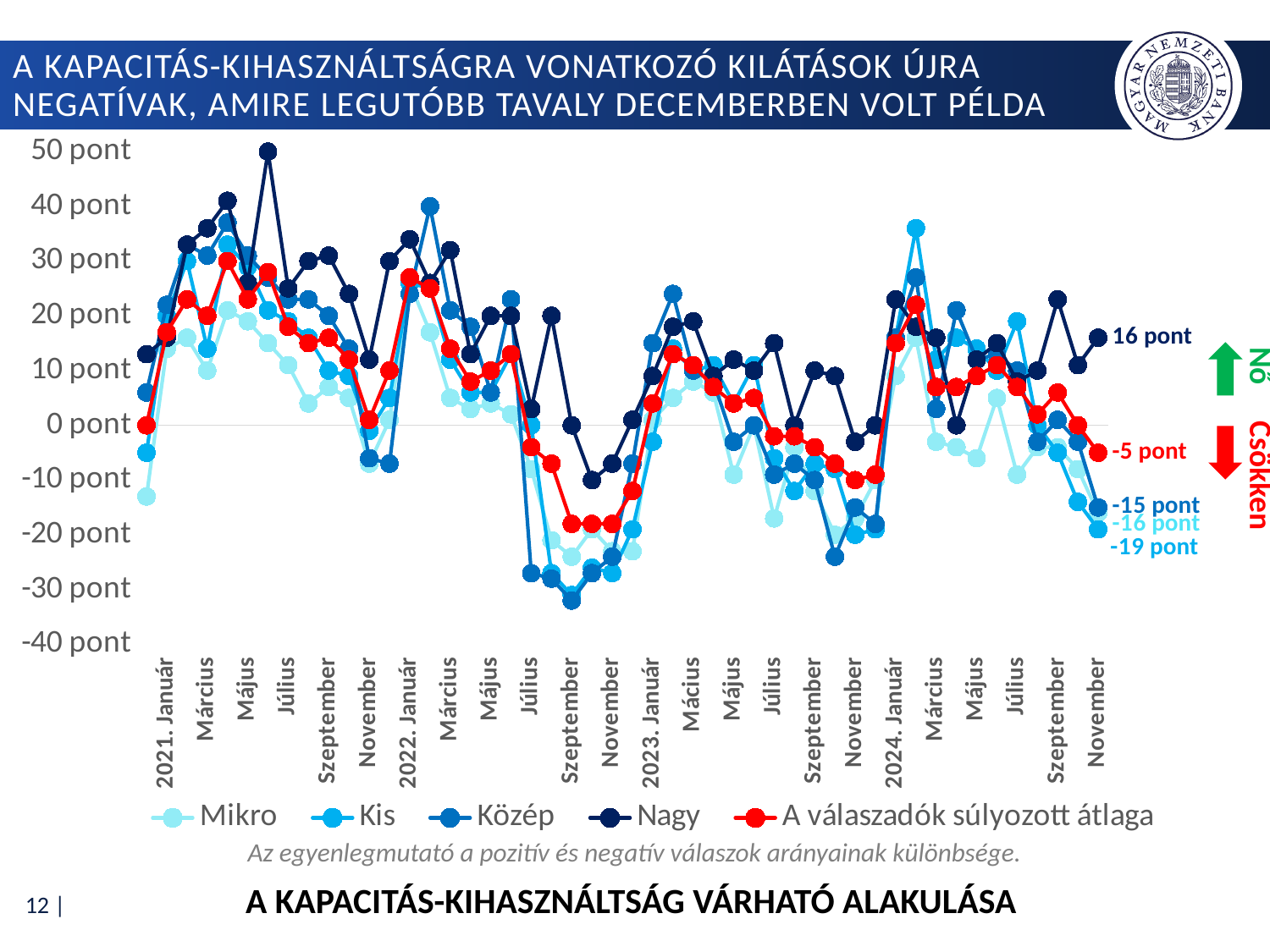
Which series is drawn in red? A válaszadók súlyozott átlaga Does 'A válaszadók súlyozott átlaga' rise or fall between January 2024 and November 2024? fall What is the difference between the Nagy value (16 pont) and the weighted average value (-5 pont) at the last data point? 21 pont Is the value of the Nagy series in September 2022 greater or less than -20 pont? greater What kind of chart is shown on the slide? line chart At the last data point, which is larger: the Nagy series or 'A válaszadók súlyozott átlaga'? Nagy Is the value of 'A válaszadók súlyozott átlaga' in September 2022 greater or less than -10 pont? less What is the title of the chart shown at the bottom of the slide? A KAPACITÁS-KIHASZNÁLTSÁG VÁRHATÓ ALAKULÁSA What is the value of the Nagy series at the last data point (November 2024)? 16 pont How many series does the legend list? 5 What is the value of 'A válaszadók súlyozott átlaga' at the last data point (November 2024)? -5 pont Is the value of the Nagy series in July 2021 greater or less than 40 pont? less